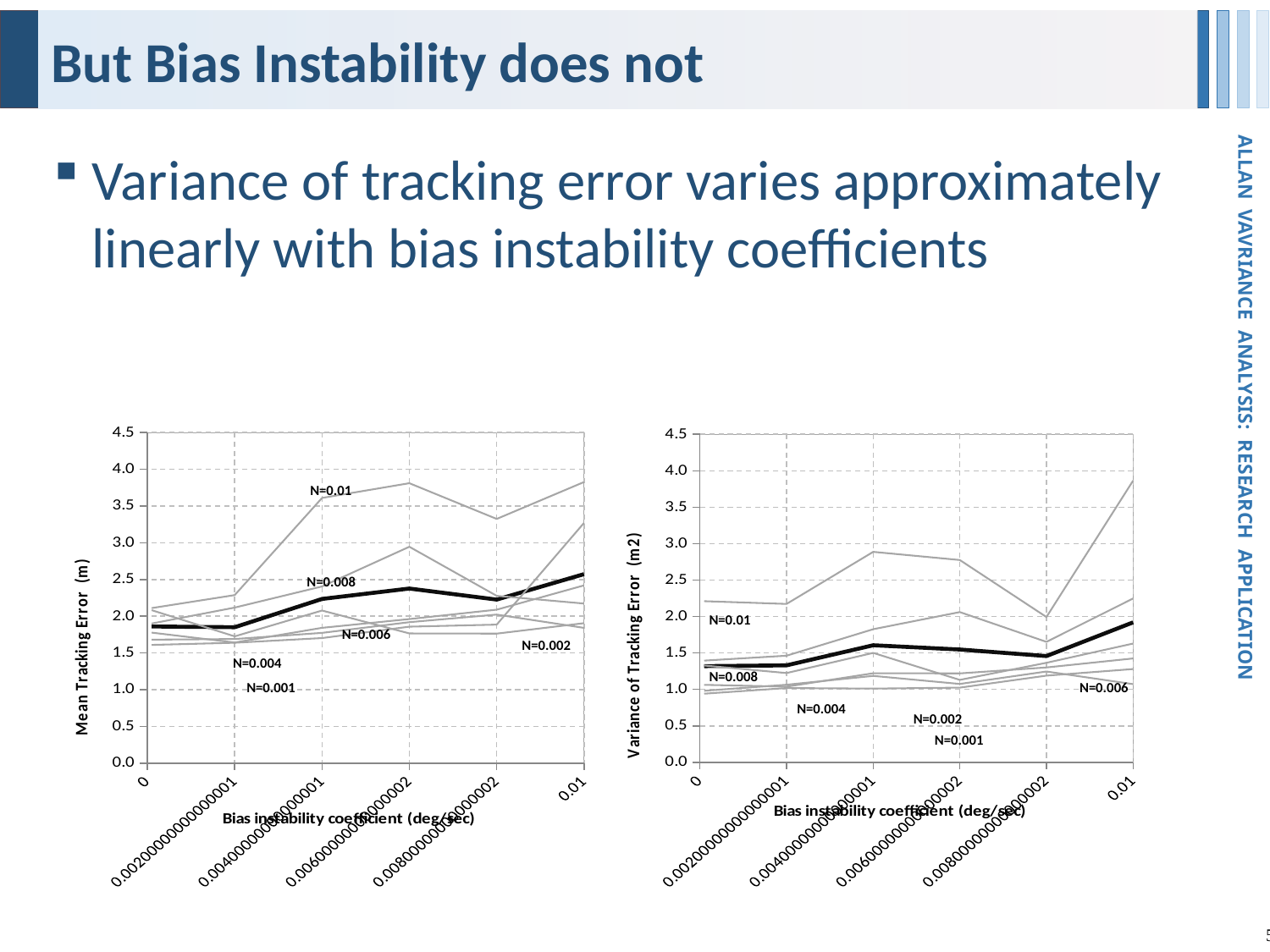
On the right chart, which N series has the highest value at x=0.01? N=0.01 On the right chart, does the bold N=0.008 line rise or fall overall from x=0 to x=0.01? rise On the right chart, is the value of the N=0.01 line at x=0.01 greater or less than 3.5? greater What is the x-axis title of the left chart? Bias instability coefficient (deg/sec) On the left chart, which N series has the highest value at x=0.006? N=0.01 What is the y-axis title of the right chart? Variance of Tracking Error (m2) What type of chart is the left chart on the slide? line chart On the right chart, is the value of the N=0.01 line at x=0 greater or less than 2.0? greater On the left chart, is the value of the N=0.01 line at x=0.01 greater or less than 3.5? greater How many labelled N series are plotted on the left chart? 6 How many x-axis tick values are shown on the right chart? 6